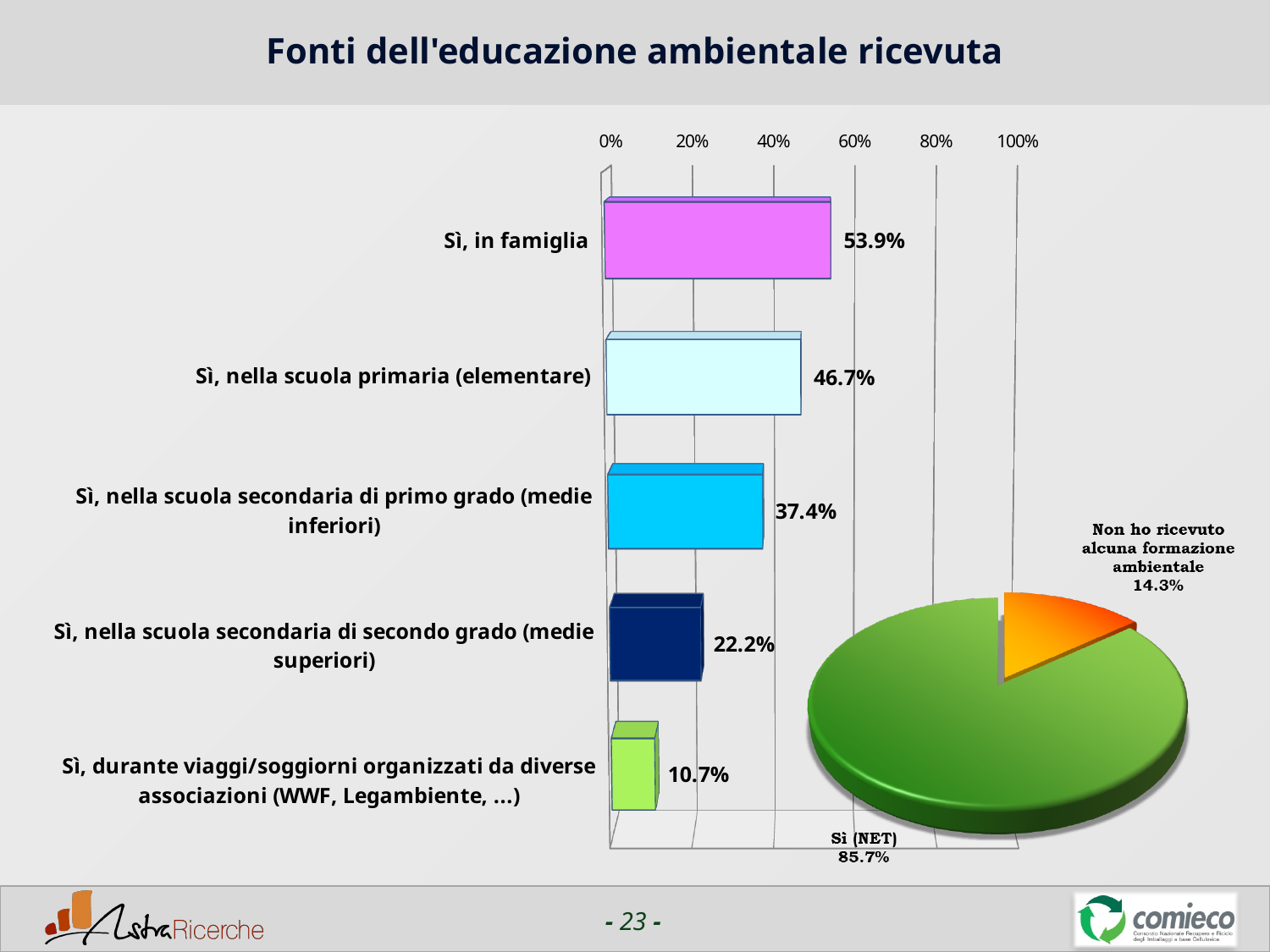
How many categories does the bar chart show? 5 In the bar chart, what is the value for "Sì, nella scuola primaria (elementare)"? 46.7% In the bar chart, which is larger: "Sì, nella scuola secondaria di primo grado (medie inferiori)" or "Sì, nella scuola secondaria di secondo grado (medie superiori)"? Sì, nella scuola secondaria di primo grado (medie inferiori) What kind of chart is the chart on the left of the slide? Bar chart In the bar chart, what is the difference between "Sì, nella scuola secondaria di primo grado (medie inferiori)" and "Sì, nella scuola secondaria di secondo grado (medie superiori)"? 15.2 percentage points In the pie chart, what share is labelled "Sì (NET)"? 85.7% In the bar chart, what is the difference between "Sì, in famiglia" and "Sì, nella scuola primaria (elementare)"? 7.2 percentage points In the bar chart, what is the value for "Sì, nella scuola secondaria di secondo grado (medie superiori)"? 22.2% In the bar chart, what is the value for "Sì, in famiglia"? 53.9% In the bar chart, which category has the highest value? Sì, in famiglia In the pie chart, what share is labelled "Non ho ricevuto alcuna formazione ambientale"? 14.3% In the bar chart, which category has the lowest value? Sì, durante viaggi/soggiorni organizzati da diverse associazioni (WWF, Legambiente, ...)